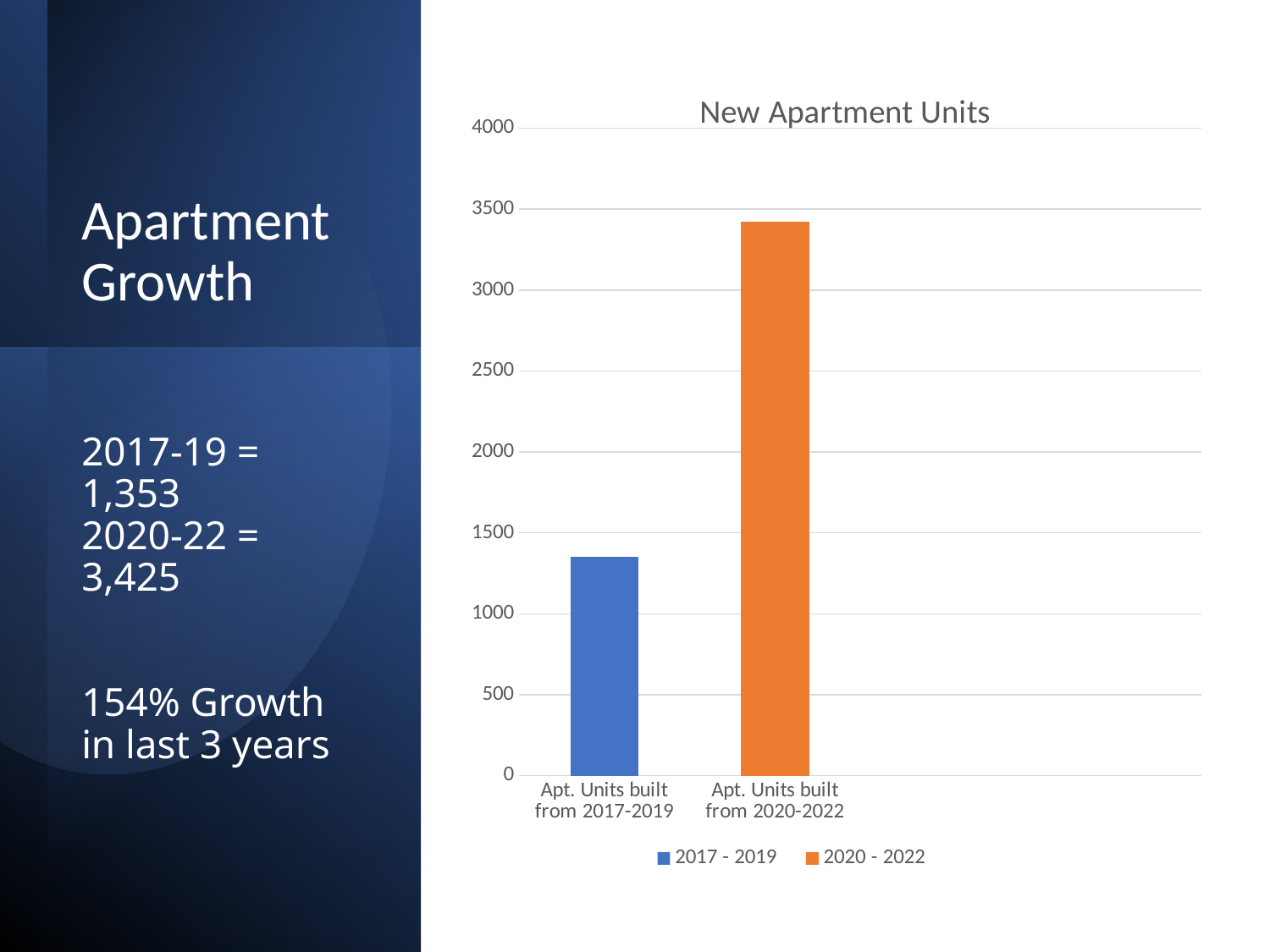
What type of chart is shown on the slide? bar chart How many apartment units were built from 2020-2022, according to the slide? 3,425 What is the title of the chart? New Apartment Units Is the value for Apt. Units built from 2020-2022 greater or less than 3000? greater How many apartment units were built from 2017-2019, according to the slide? 1,353 How many entries does the chart legend list? 2 How many bars (categories) are plotted in the chart? 2 Which category has the highest value in the chart? Apt. Units built from 2020-2022 Is the value for Apt. Units built from 2017-2019 greater or less than 1500? less What is the difference between the units built from 2020-2022 and the units built from 2017-2019? 2,072 Do the values rise or fall from the 2017-2019 bar to the 2020-2022 bar? rise Which category has the lowest value in the chart? Apt. Units built from 2017-2019